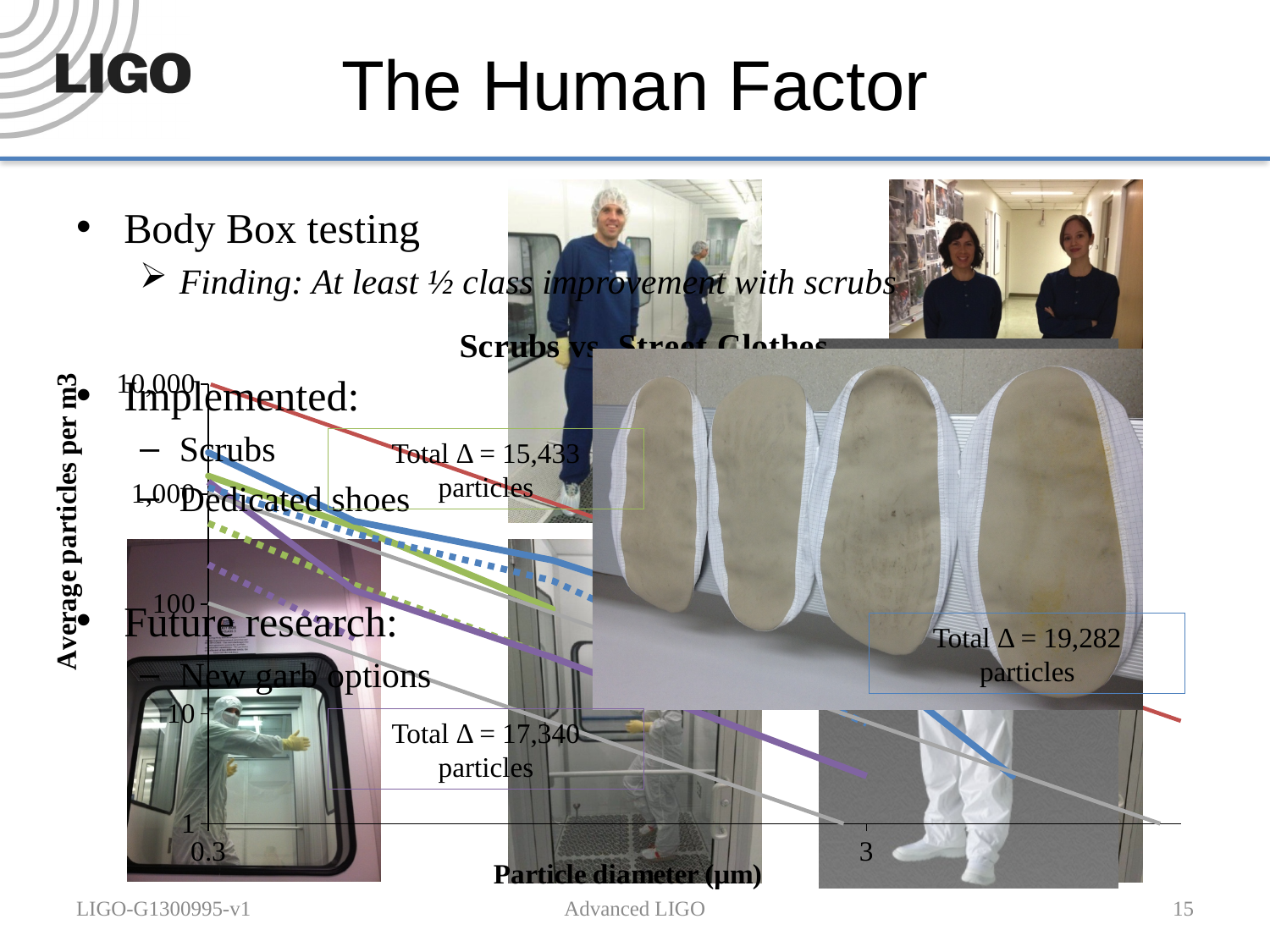
How many tick labels are shown on the particle diameter axis? 2 What is the label of the chart's vertical axis? Average particles per m3 Is the value of the red line at a particle diameter of 0.3 μm greater or less than 1,000? greater What is the title of the chart? Scrubs vs. Street Clothes Do the plotted lines rise or fall as particle diameter increases from 0.3 to 3 μm? fall Which of the three 'Total Δ' annotations on the chart shows the smallest number of particles? Total Δ = 15,433 particles What kind of chart is shown on the slide? line chart Is the value of the purple line at a particle diameter of 3 μm greater or less than 10? less Which of the three 'Total Δ' annotations on the chart shows the largest number of particles? Total Δ = 19,282 particles What is the difference between the largest Total Δ (19,282 particles) and the smallest Total Δ (15,433 particles) annotated on the chart? 3,849 particles